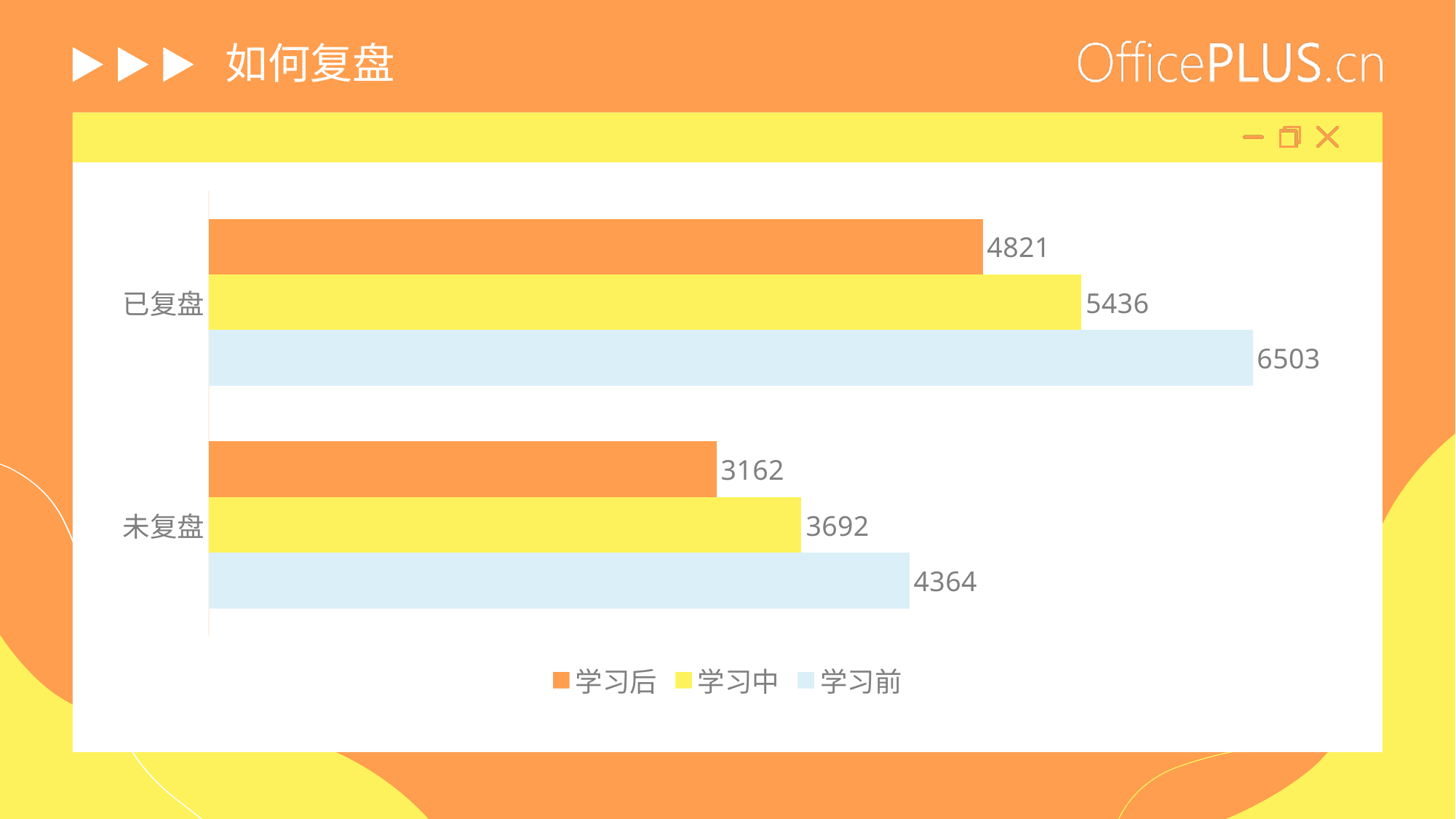
What is the value for 学习中 in the 已复盘 category? 5436 How many categories are shown on the chart? 2 What colour represents the 学习前 series? Light blue Which is larger: 学习后 for 已复盘 or 学习前 for 未复盘? 学习后 for 已复盘 How many series does the legend list? 3 Which series has the highest value in the 已复盘 category? 学习前 Which series has the lowest value in the 未复盘 category? 学习后 What is the value for 学习前 in the 未复盘 category? 4364 What is the difference between 学习中 and 学习后 in the 未复盘 category? 530 What is the difference between the 学习前 values for 已复盘 and 未复盘? 2139 What is the value for 学习后 in the 已复盘 category? 4821 What kind of chart is shown on the slide? Bar chart